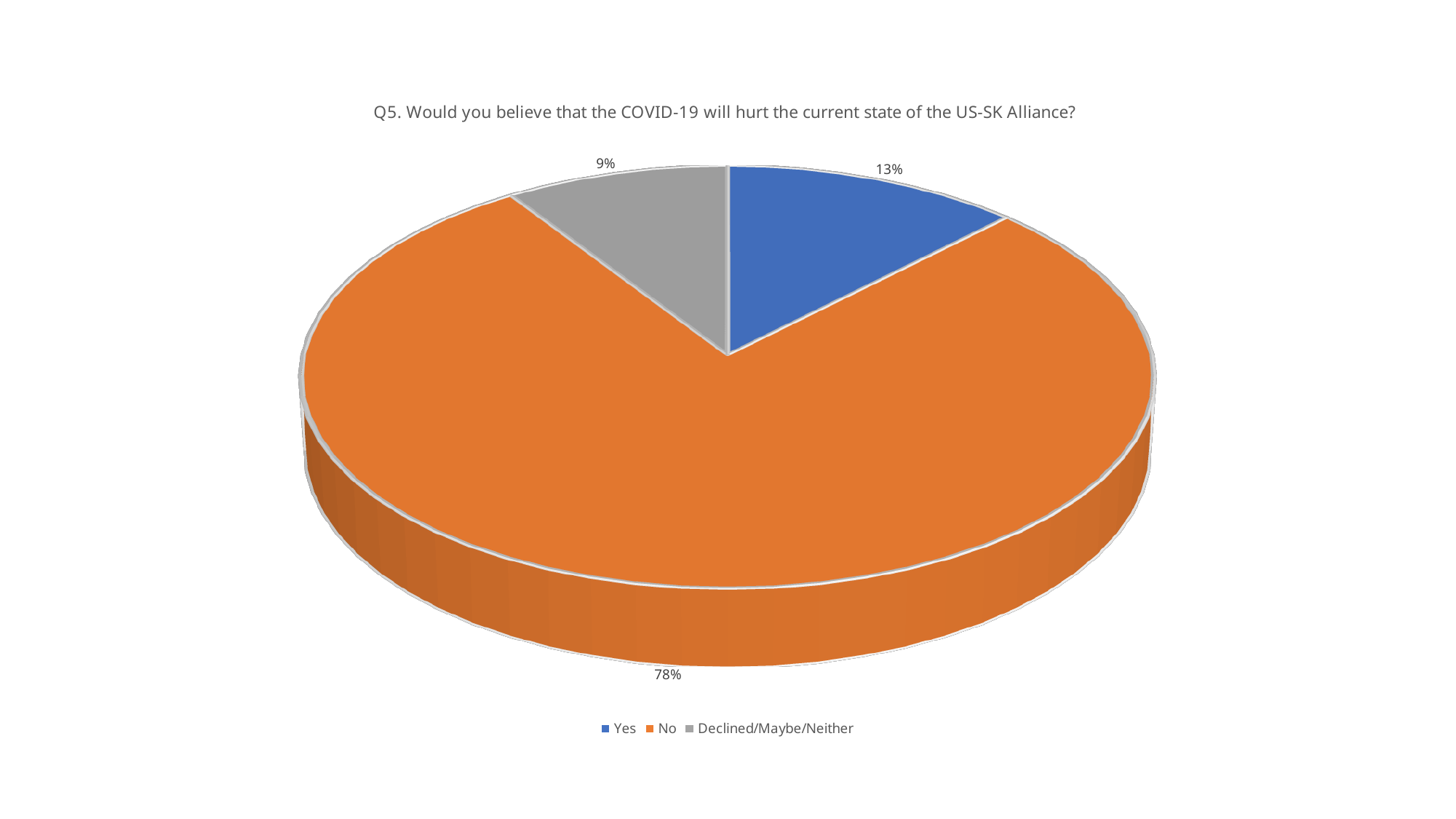
What kind of chart is shown on the slide? Pie chart Which response has the smallest share of the pie? Declined/Maybe/Neither What is the difference in percentage points between the "No" and "Yes" shares? 65 What is the difference in percentage points between the "Yes" and "Declined/Maybe/Neither" shares? 4 What percentage of respondents fall under "Declined/Maybe/Neither"? 9% What percentage of respondents answered "No"? 78% What colour is the "No" slice? Orange Which is larger, the share for "Yes" or the share for "Declined/Maybe/Neither"? Yes What percentage of respondents answered "Yes"? 13% Which response has the largest share of the pie? No How many entries does the legend list? 3 How many slices does the pie chart have? 3